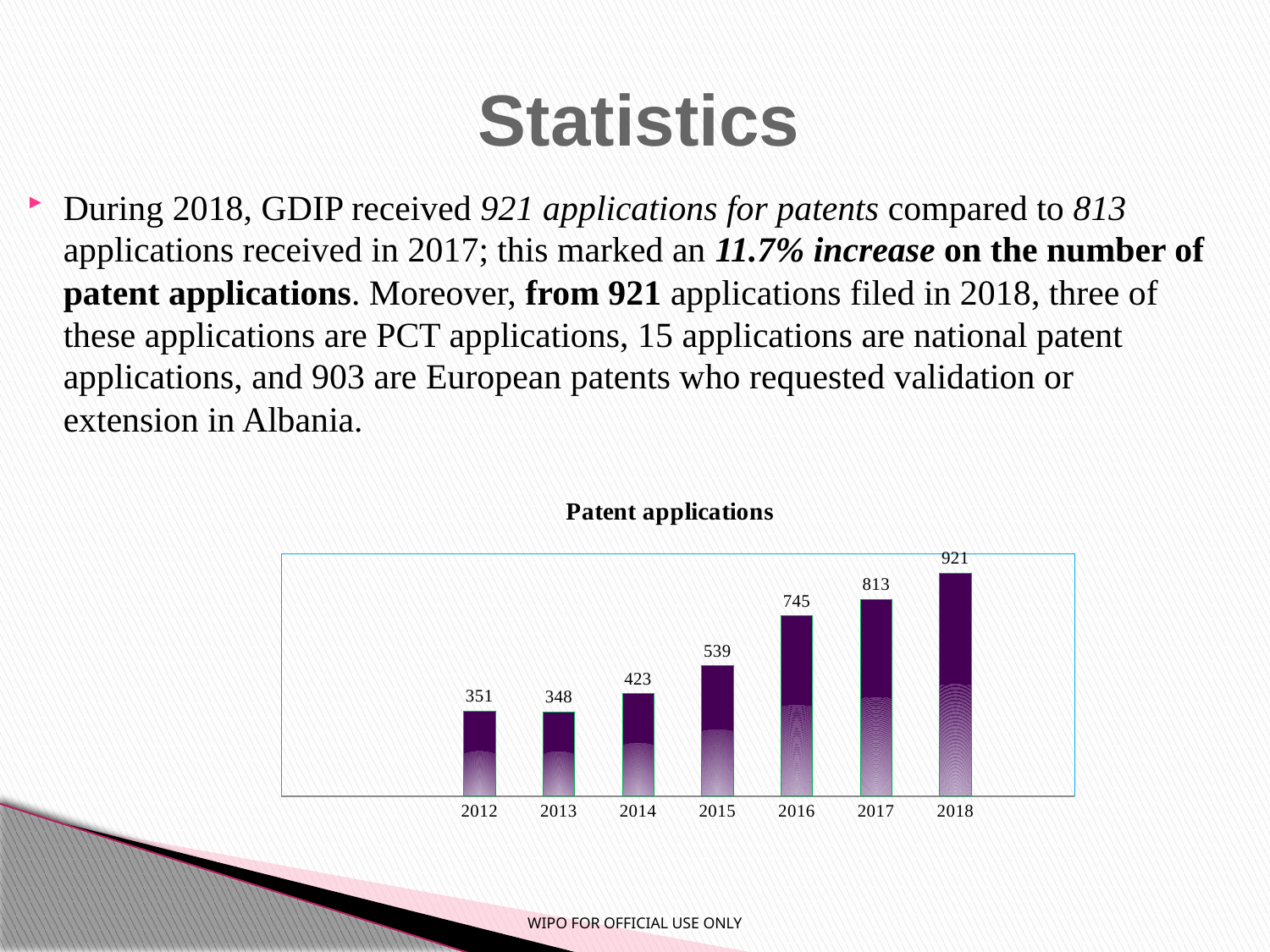
What kind of chart is the Patent applications chart? Bar chart What is the difference between the values for 2016 and 2015 in the Patent applications chart? 206 What is the title of the chart on the slide? Patent applications What is the value for 2012 in the Patent applications chart? 351 What is the value for 2015 in the Patent applications chart? 539 Which is larger in the Patent applications chart, the value for 2014 or the value for 2013? 2014 Which year has the highest value in the Patent applications chart? 2018 What is the difference between the values for 2018 and 2017 in the Patent applications chart? 108 What is the value for 2016 in the Patent applications chart? 745 Do the values in the Patent applications chart generally rise or fall from 2013 to 2018? Rise How many years are shown in the Patent applications chart? 7 Which year has the lowest value in the Patent applications chart? 2013